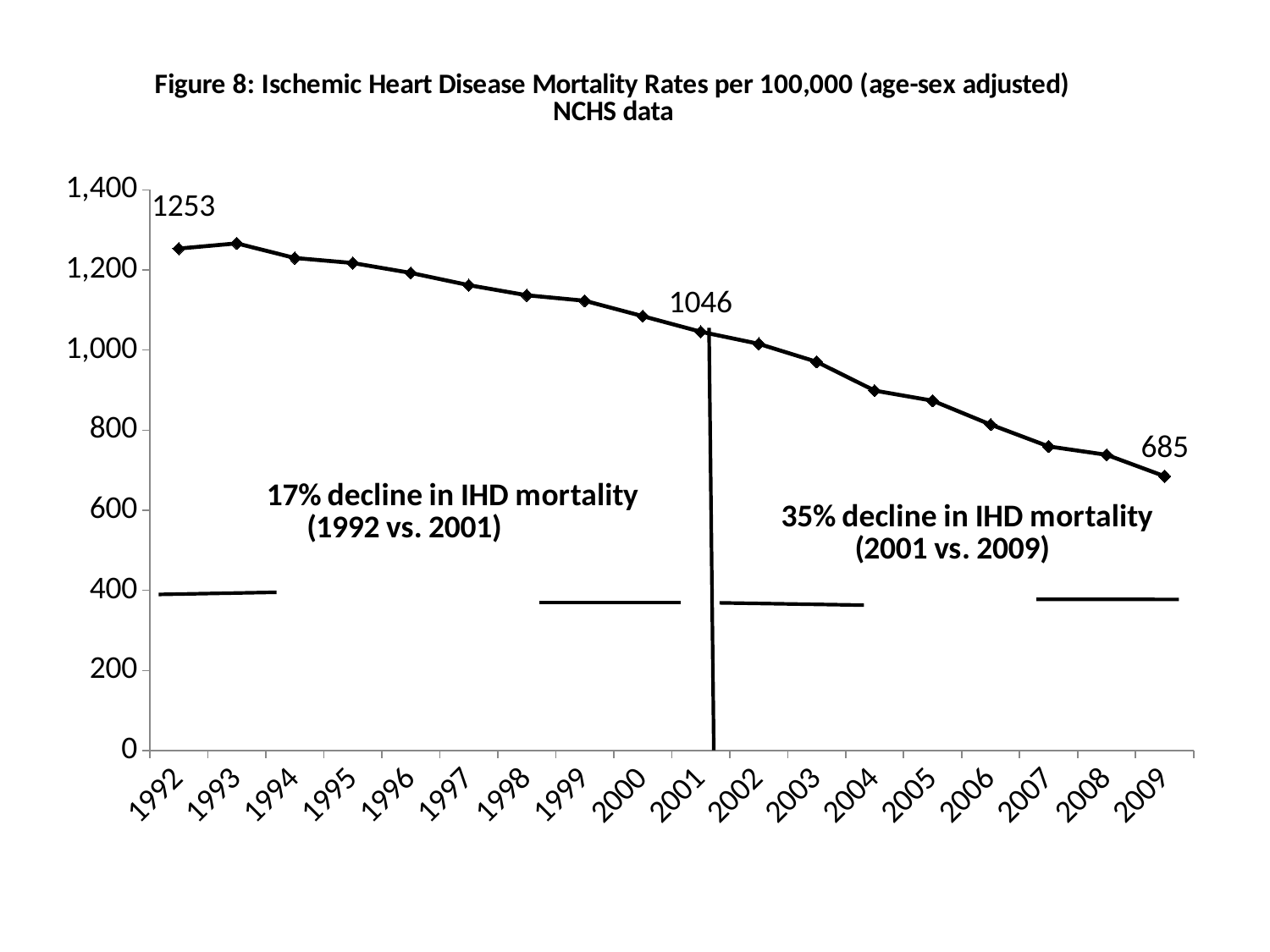
Which year has the lowest IHD mortality rate? 2009 What is the IHD mortality rate per 100,000 for 2001? 1046 Do the mortality rates rise or fall from 1992 to 2009? Fall Is the value for 2003 greater or less than 1,000? less What is the difference between the 1992 and 2009 mortality rates? 568 What is the IHD mortality rate per 100,000 for 1992? 1253 What is the difference between the 2001 and 2009 mortality rates? 361 How many years are plotted on the x axis? 18 What is the IHD mortality rate per 100,000 for 2009? 685 Which year has a higher mortality rate, 1996 or 2004? 1996 Is the value for 2005 greater or less than 800? greater What type of chart is shown on the slide? Line chart